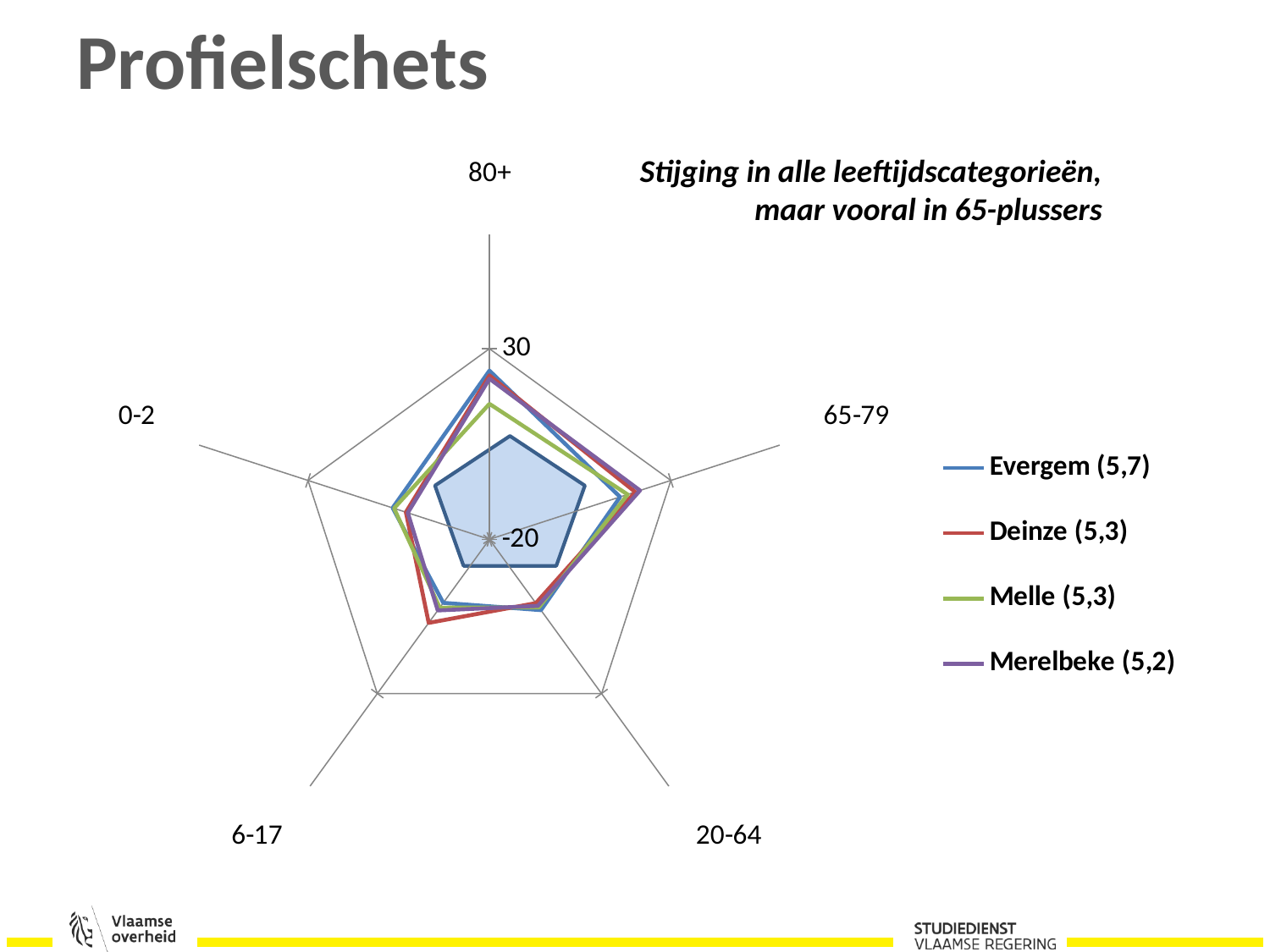
Which municipality is listed first in the legend of the radar chart? Evergem (5,7) Is the value for Melle in the 0-2 category greater or less than -20? greater What kind of chart is shown on the slide? radar chart Is the value for Deinze in the 6-17 category greater or less than 30? less Which age category is at the top of the radar chart? 80+ How many age categories are plotted on the radar chart? 5 Is the value for Melle in the 80+ category greater or less than 30? less Among the four municipalities in the legend, which has the highest value in the 6-17 category? Deinze (5,3) How many series does the legend of the radar chart list? 4 Among the four municipalities in the legend, which has the lowest value in the 80+ category? Melle (5,3) In the 80+ category, which is larger: the value for Evergem or the value for Melle? Evergem